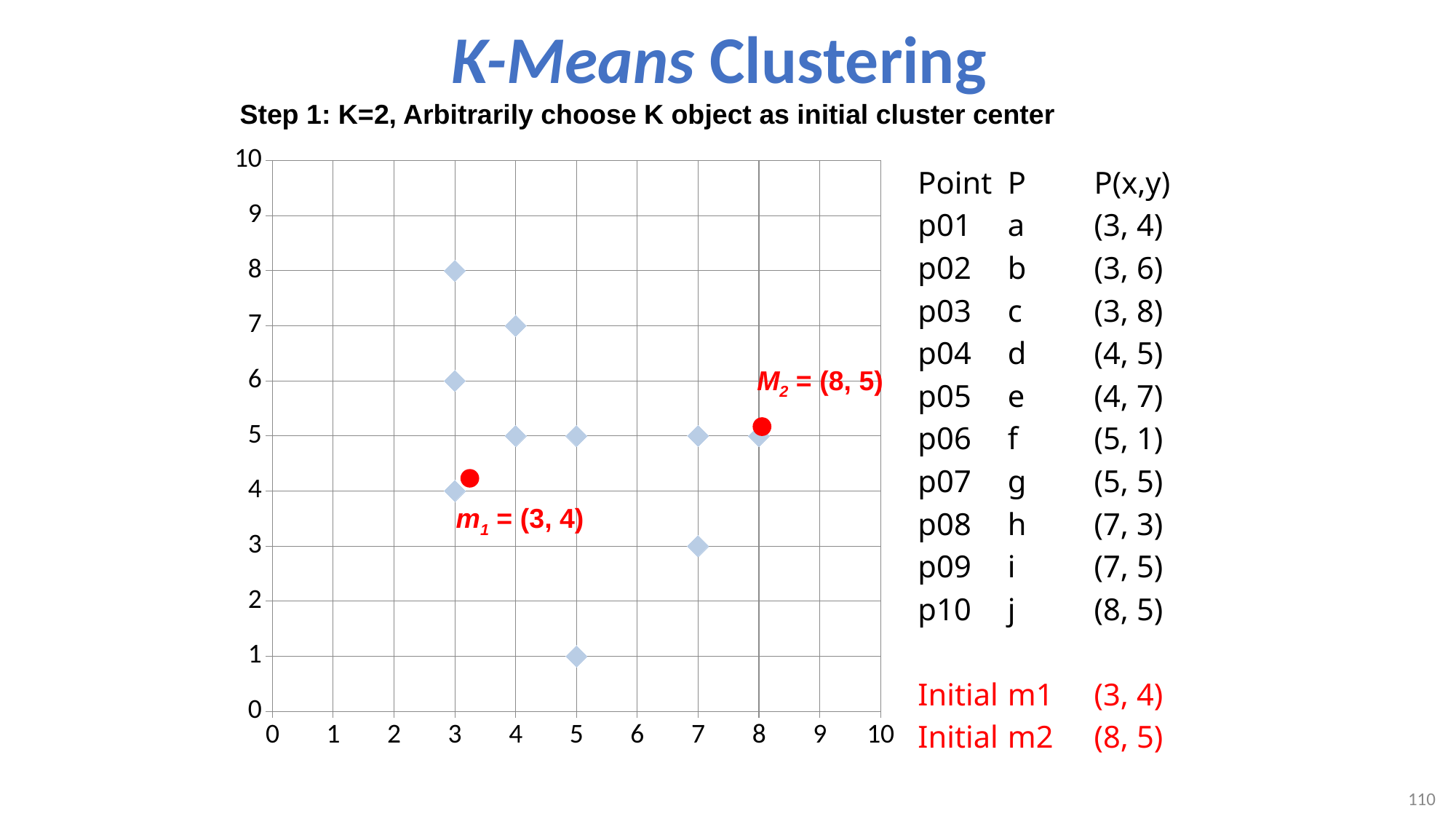
How many plotted points have a y value of 5? 4 What is the highest y value among the plotted points? 8 What kind of chart is shown on the slide? scatter chart How many data points are plotted on the scatter chart? 10 What colour are the markers for the initial cluster centers m1 and M2? red Which has the larger x coordinate, the initial center m1 or the initial center M2? M2 What is the maximum value shown on the x axis of the chart? 10 What is the difference in y value between the highest point (3, 8) and the lowest point (5, 1)? 7 What is the lowest y value among the plotted points? 1 What is the largest x value among the plotted points? 8 What are the coordinates of the initial cluster center m1 marked on the chart? (3, 4) What are the coordinates of the initial cluster center M2 marked on the chart? (8, 5)